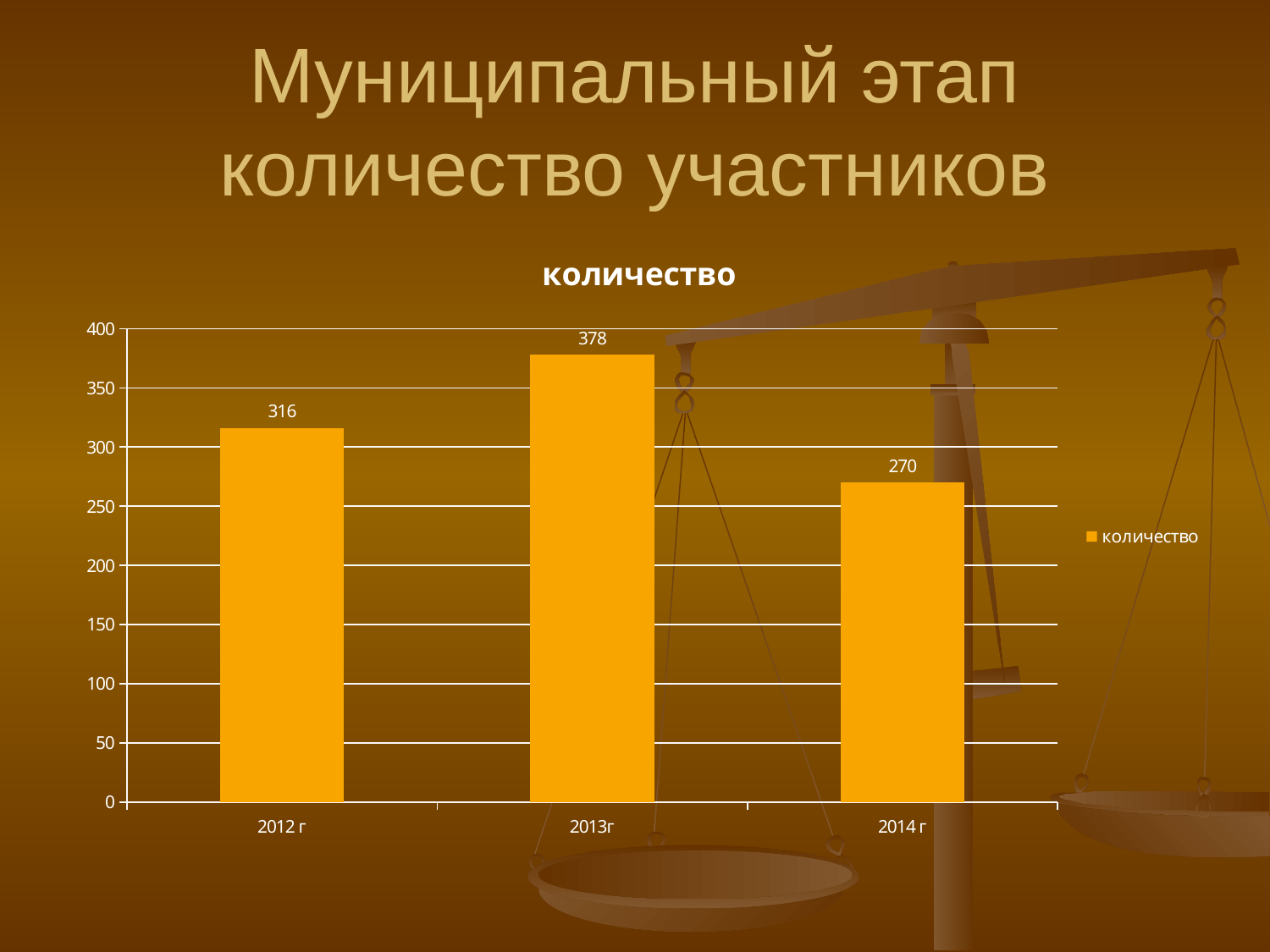
What kind of chart is shown on the slide? bar chart How many categories are shown on the x axis? 3 What is the value for 2013г? 378 Which year has the lowest value? 2014 г Which is larger, the value for 2012 г or the value for 2014 г? 2012 г Is the value for 2014 г greater or less than 300? less What is the difference between the values for 2012 г and 2014 г? 46 What is the title of the chart? количество What is the value for 2012 г? 316 What is the difference between the values for 2013г and 2012 г? 62 What is the value for 2014 г? 270 Which year has the highest value? 2013г